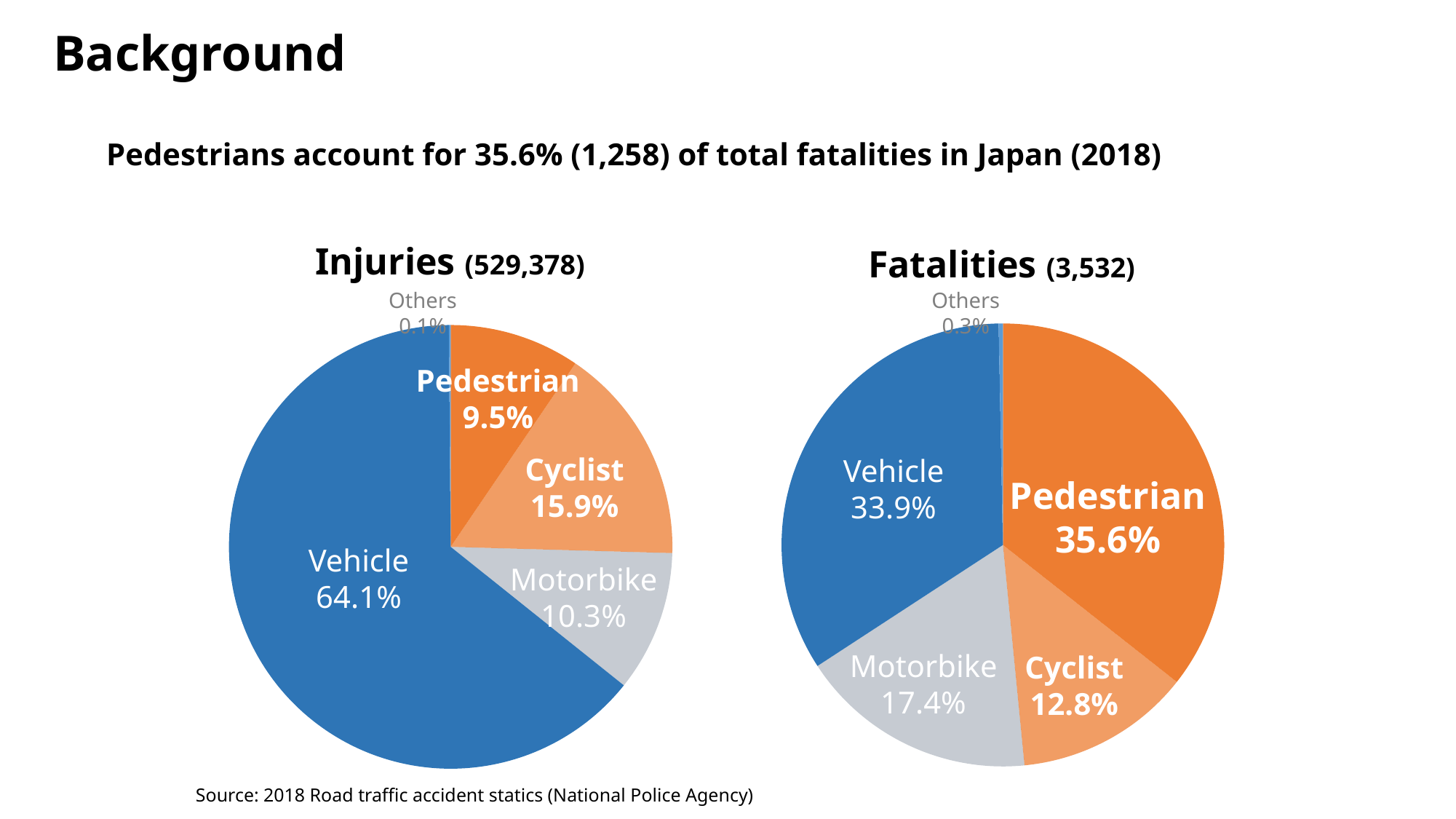
In the Injuries pie chart, what share do Vehicles account for? 64.1% In the Injuries pie chart, what is the share for Others? 0.1% In the Fatalities pie chart, what is the share for Motorbikes? 17.4% In the Injuries pie chart, which is larger: the Cyclist share or the Motorbike share? Cyclist What total number of fatalities is shown in the title of the Fatalities chart? 3,532 In the Injuries pie chart, which category has the smallest share? Others In the Fatalities pie chart, what is the difference between the Pedestrian share and the Vehicle share? 1.7% In the Fatalities pie chart, what share do Pedestrians account for? 35.6% How many categories are shown in the Fatalities pie chart? 5 In the Fatalities pie chart, which category has the largest share? Pedestrian In the Injuries pie chart, what is the share for Cyclists? 15.9% What type of chart is used for Injuries? Pie chart